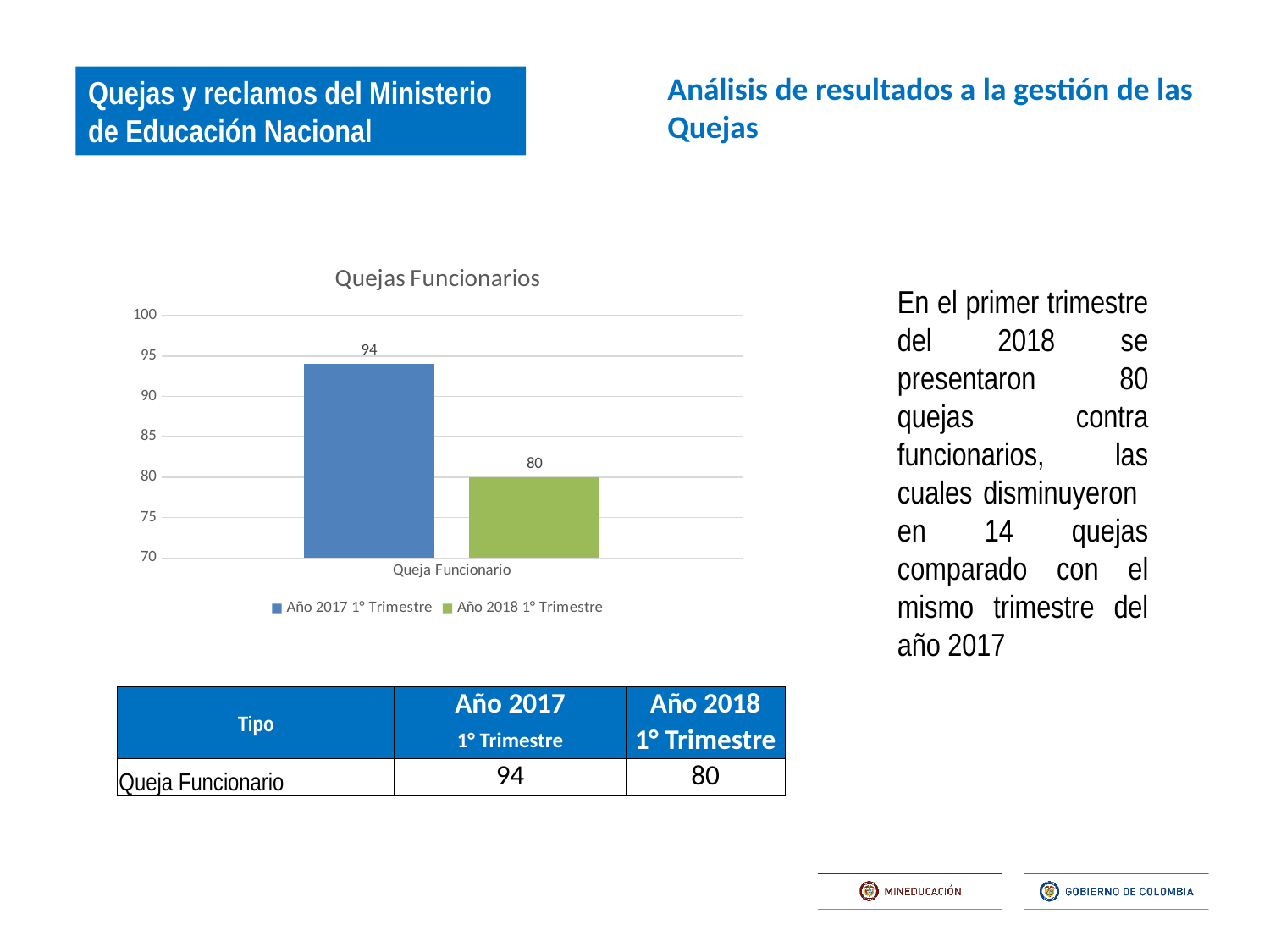
How many categories are shown on the x axis of the Quejas Funcionarios chart? 1 What is the value for Año 2018 1° Trimestre in the Quejas Funcionarios chart? 80 Is the value for Año 2017 1° Trimestre greater or less than 90? greater Is the value for Año 2017 1° Trimestre larger or smaller than the value for Año 2018 1° Trimestre? larger How many series does the legend of the Quejas Funcionarios chart list? 2 Is the value for Año 2018 1° Trimestre greater or less than 85? less What is the title of the chart on the slide? Quejas Funcionarios Which series has the lower value in the Quejas Funcionarios chart? Año 2018 1° Trimestre Which series has the higher value in the Quejas Funcionarios chart? Año 2017 1° Trimestre What kind of chart is the Quejas Funcionarios chart? bar chart What is the value for Año 2017 1° Trimestre in the Quejas Funcionarios chart? 94 What is the difference between the Año 2017 1° Trimestre and Año 2018 1° Trimestre values in the Quejas Funcionarios chart? 14